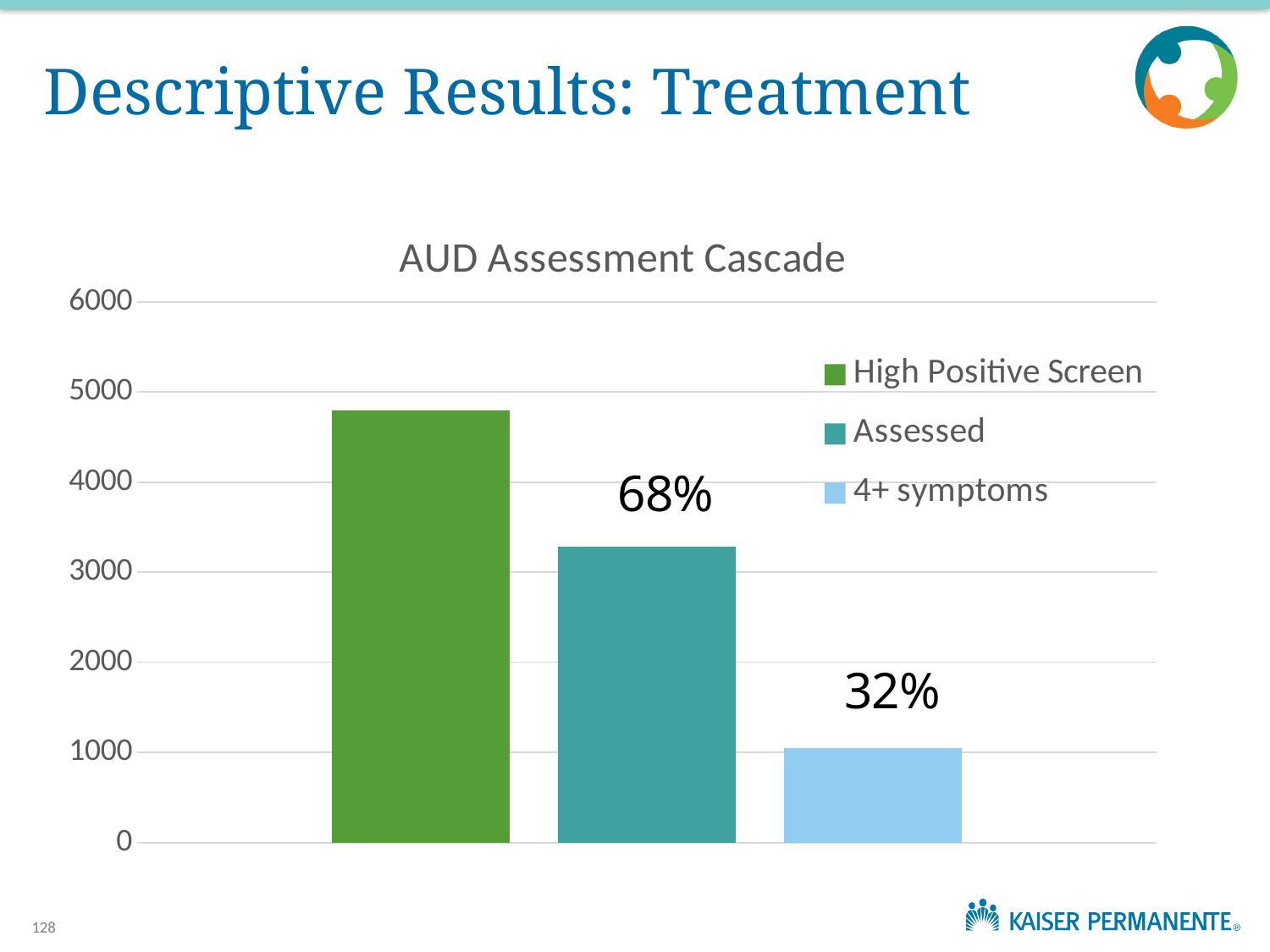
Do the bar values rise or fall from left to right across the chart? fall Which series has the highest bar? High Positive Screen How many bars are plotted in the chart? 3 Is the value for 4+ symptoms greater or less than 2000? less Which is larger, the Assessed bar or the 4+ symptoms bar? Assessed What kind of chart is shown on the slide? bar chart How many series does the legend list? 3 What percentage label is printed above the Assessed bar? 68% Is the value for Assessed greater or less than 3000? greater Is the value for High Positive Screen greater or less than 4000? greater What is the title of the chart? AUD Assessment Cascade Which series has the lowest bar? 4+ symptoms